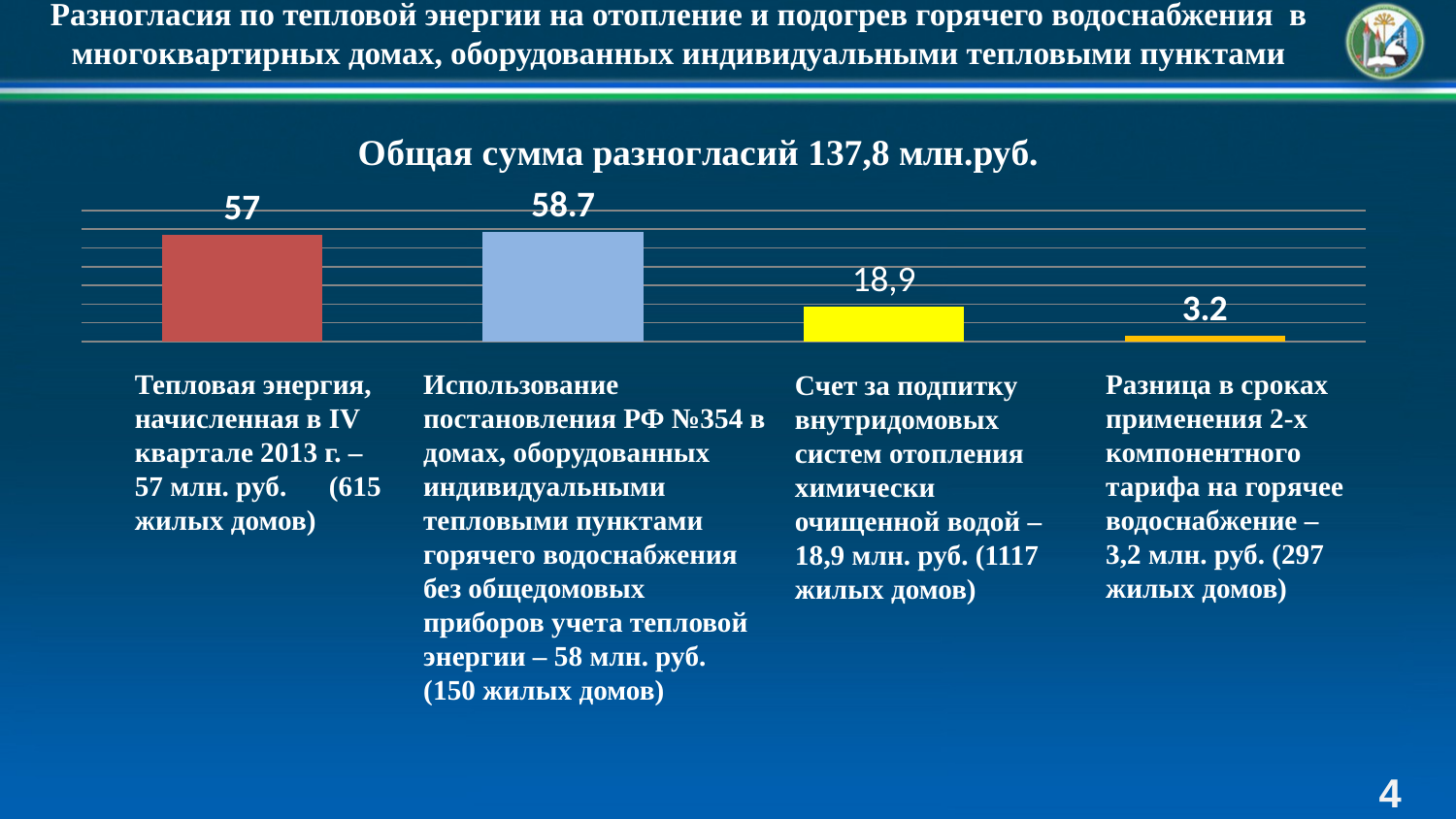
What is the value shown for the bar labelled 'Разница в сроках применения 2-х компонентного тарифа на горячее водоснабжение'? 3.2 What is the value shown for the bar labelled 'Счет за подпитку внутридомовых систем отопления химически очищенной водой'? 18,9 Which category has the highest value in the chart? Использование постановления РФ №354 Which is larger: the value for 'Счет за подпитку внутридомовых систем отопления' or the value for 'Разница в сроках применения 2-х компонентного тарифа'? Счет за подпитку внутридомовых систем отопления What is the value shown for the bar labelled 'Тепловая энергия, начисленная в IV квартале 2013 г.'? 57 Which category has the lowest value in the chart? Разница в сроках применения 2-х компонентного тарифа на горячее водоснабжение What total sum of disagreements is stated in the chart title? 137,8 млн.руб. How many bars are plotted in the chart? 4 What type of chart is shown on the slide? bar chart What colour is the bar for 'Счет за подпитку внутридомовых систем отопления химически очищенной водой'? yellow What is the difference between the value for 'Использование постановления РФ №354' (58.7) and the value for 'Тепловая энергия, начисленная в IV квартале 2013 г.' (57)? 1.7 What is the value shown for the bar labelled 'Использование постановления РФ №354'? 58.7